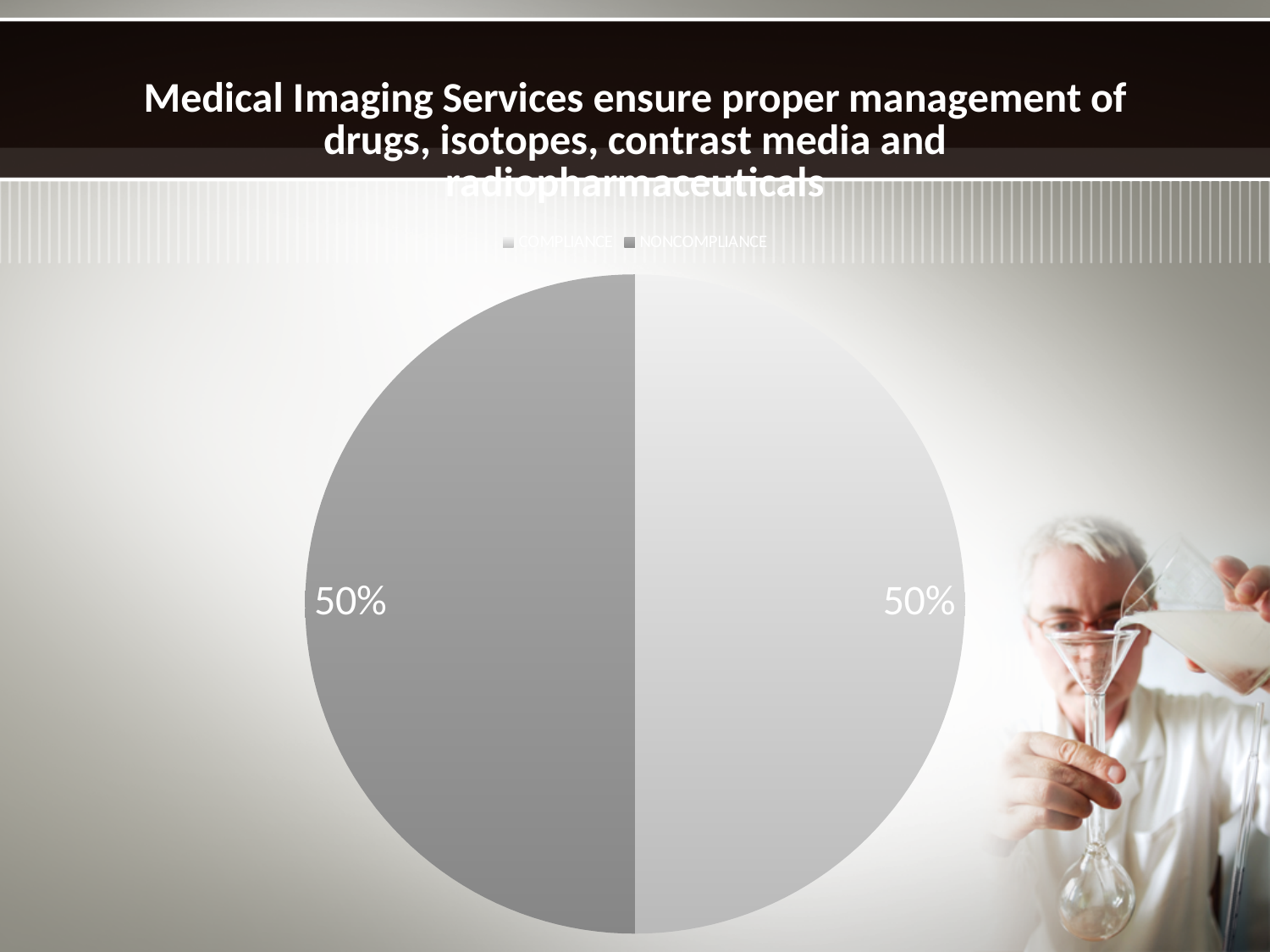
Is the value for COMPLIANCE greater than, less than, or equal to the value for NONCOMPLIANCE? equal What kind of chart is shown on the slide? pie chart What percentage is shown for the NONCOMPLIANCE slice? 50% How many slices does the pie chart have? 2 How many entries does the legend of the pie chart list? 2 What is the difference between the COMPLIANCE and NONCOMPLIANCE percentages? 0% What percentage is shown for the COMPLIANCE slice? 50% What are the two legend entries of the pie chart? COMPLIANCE and NONCOMPLIANCE Which legend entry is shown in the darker gray colour? NONCOMPLIANCE What share of the pie does NONCOMPLIANCE represent? 50%